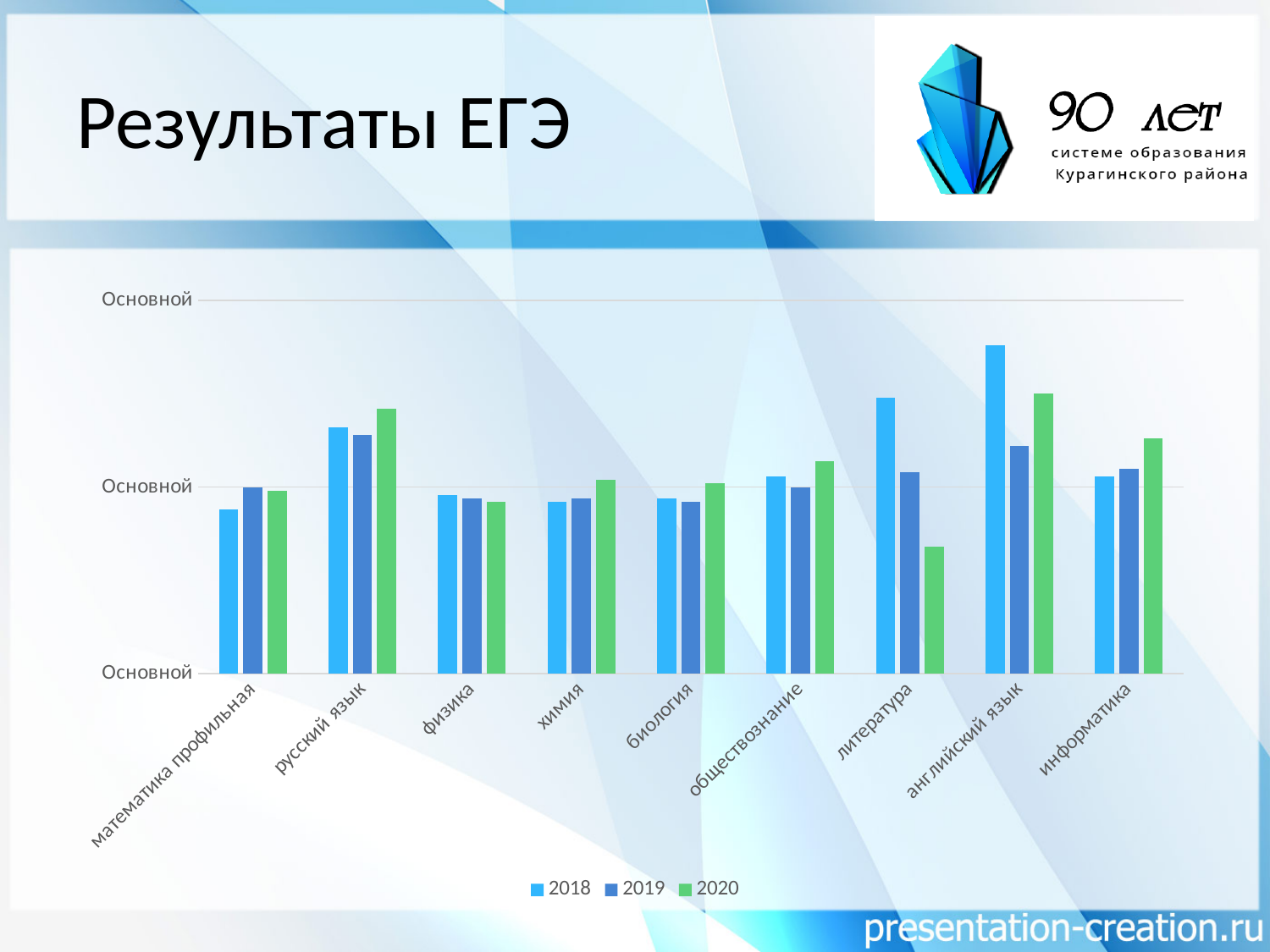
What is the title of the slide containing the chart? Результаты ЕГЭ For русский язык, which year has the larger value, 2018 or 2020? 2020 For литература, which year has the larger value, 2018 or 2020? 2018 How many subject categories are shown on the x axis of the chart? 9 Which series is shown in green in the chart legend? 2020 Which subject has the lowest bar for the 2018 series? математика профильная How many series does the chart legend list? 3 For информатика, which year has the larger value, 2018 or 2020? 2020 Which subject has the highest bar for the 2018 series? английский язык What kind of chart is shown on the slide? bar chart Which subject has the lowest bar for the 2020 series? литература